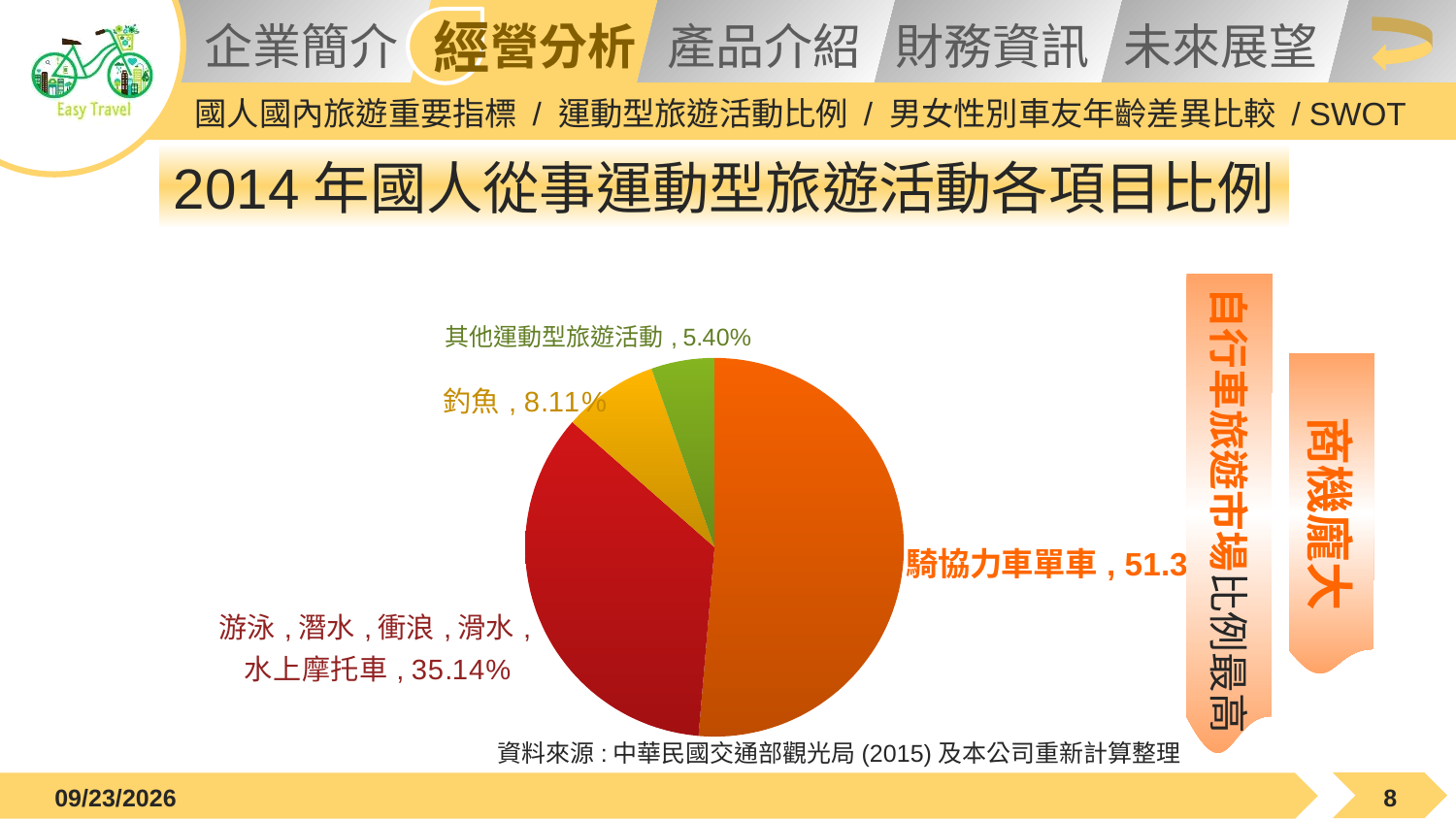
What is the value shown for 游泳，潛水，衝浪，滑水，水上摩托車 in the pie chart? 35.14% Which is larger, the slice for 釣魚 or the slice for 其他運動型旅遊活動? 釣魚 What is the difference between the values for 游泳，潛水，衝浪，滑水，水上摩托車 and 釣魚? 27.03% What kind of chart is shown on the slide? pie chart What is the value shown for 釣魚 in the pie chart? 8.11% How many slices does the pie chart have? 4 What is the value shown for 其他運動型旅遊活動 in the pie chart? 5.40% Which category has the smallest slice in the pie chart? 其他運動型旅遊活動 What is the difference between the values for 釣魚 and 其他運動型旅遊活動? 2.71% What colour is the slice for 騎協力車單車 in the pie chart? orange Which category has the largest slice in the pie chart? 騎協力車單車 What is the title of the chart on the slide? 2014 年國人從事運動型旅遊活動各項目比例